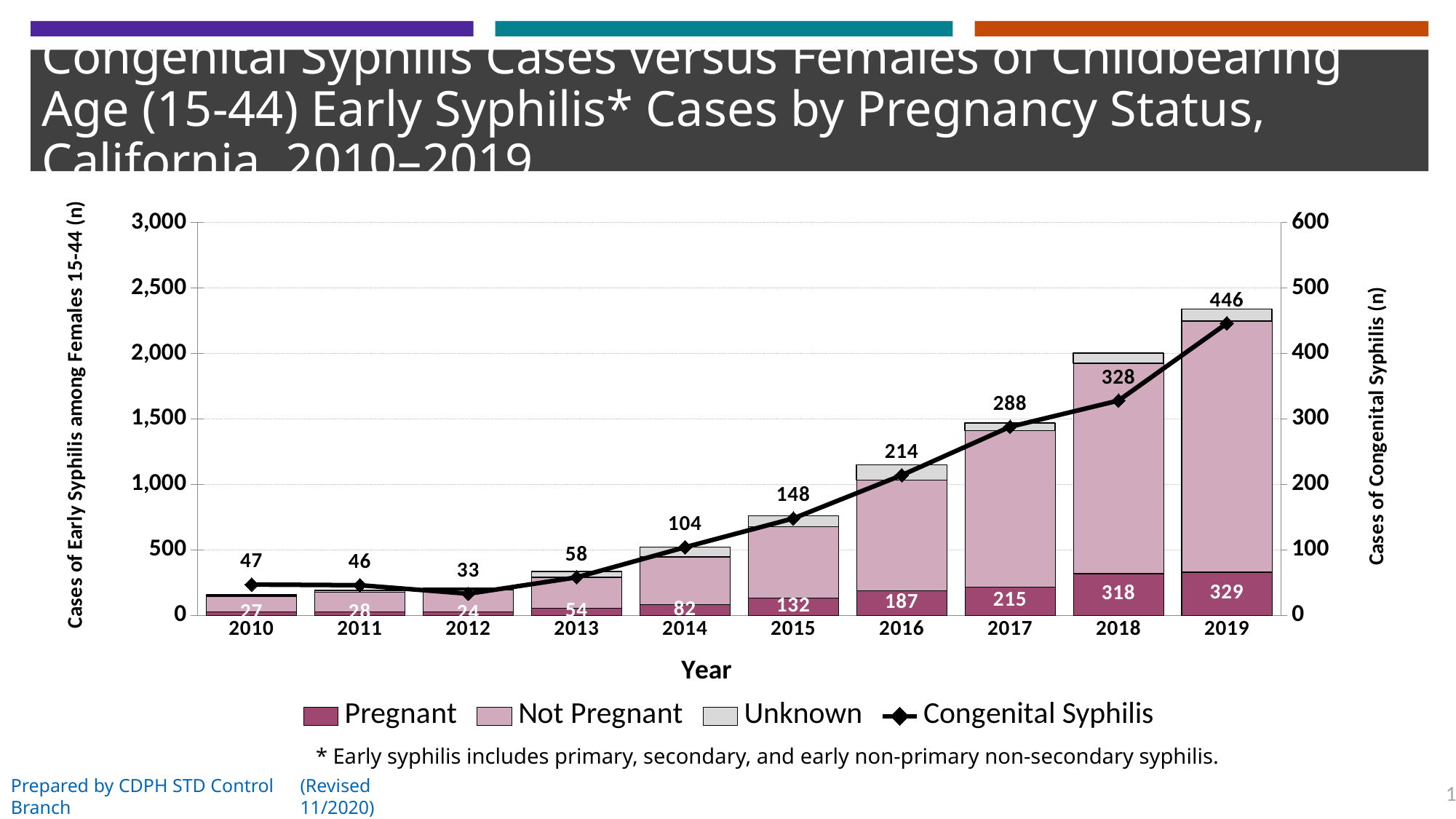
What is the Congenital Syphilis value for 2019? 446 Does the Congenital Syphilis line generally rise or fall from 2012 to 2019? rise Is the total stacked bar for 2019 greater or less than 2,000 on the left axis? greater Which year has the highest Pregnant value? 2019 What is the Pregnant value for 2018? 318 How many years are shown on the x axis? 10 What is the difference between the Pregnant values for 2017 and 2016? 28 Which year has the lowest Congenital Syphilis value? 2012 How many series does the legend list? 4 What is the Congenital Syphilis value for 2014? 104 Which is larger, the Congenital Syphilis value for 2011 or for 2013? 2013 What is the difference between the Congenital Syphilis values for 2019 and 2018? 118